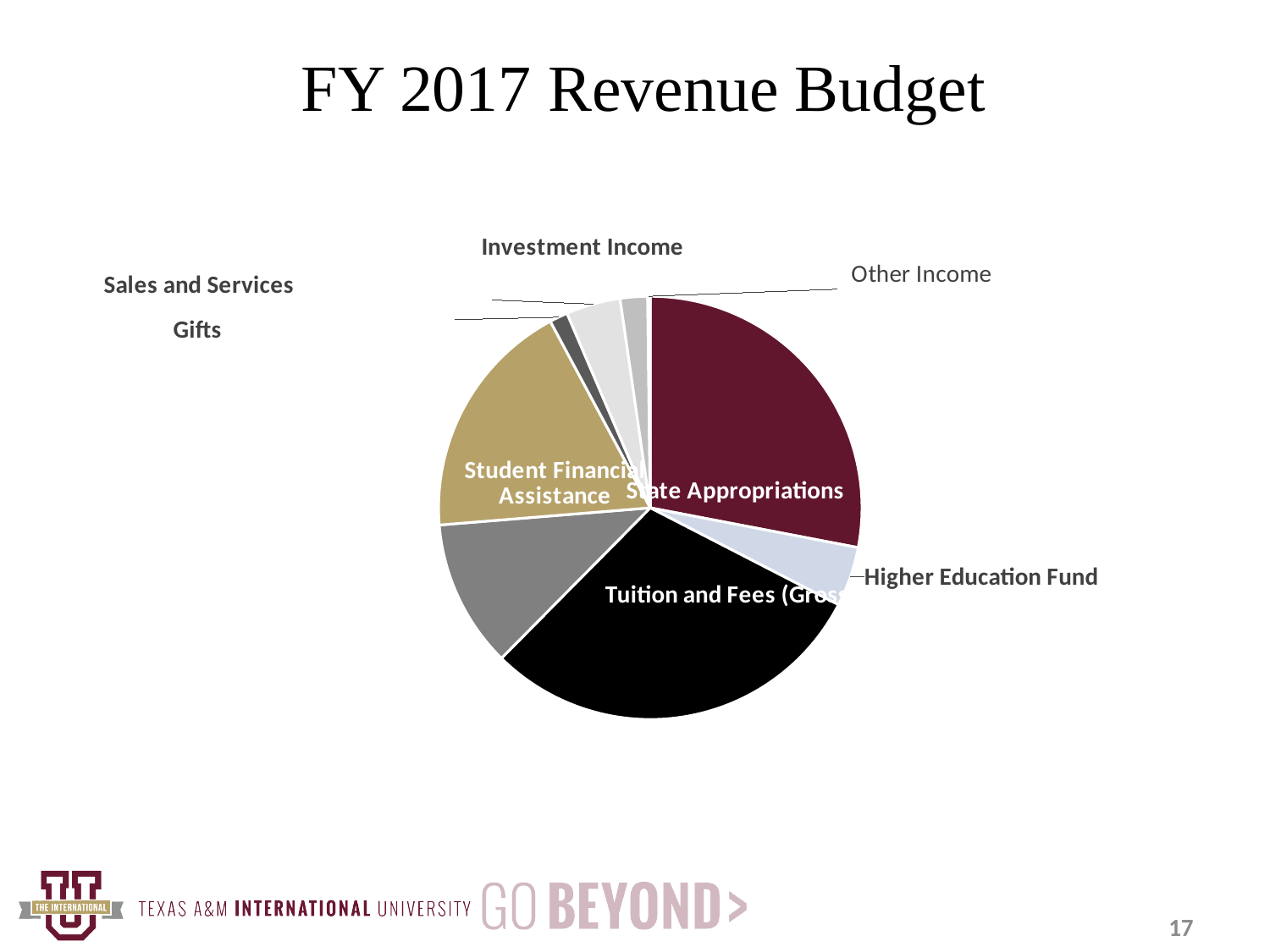
Which slice is larger, Student Financial Assistance or Investment Income? Student Financial Assistance What kind of chart is shown on the slide? pie chart Which category has the largest slice of the pie? Tuition and Fees (Gross) How many slices does the pie chart have? 9 Which category has the smallest slice of the pie? Other Income What is the title of the slide containing the pie chart? FY 2017 Revenue Budget Which slice is larger, Tuition and Fees (Gross) or State Appropriations? Tuition and Fees (Gross) Which slice is larger, State Appropriations or Higher Education Fund? State Appropriations What colour is the Tuition and Fees (Gross) slice? black